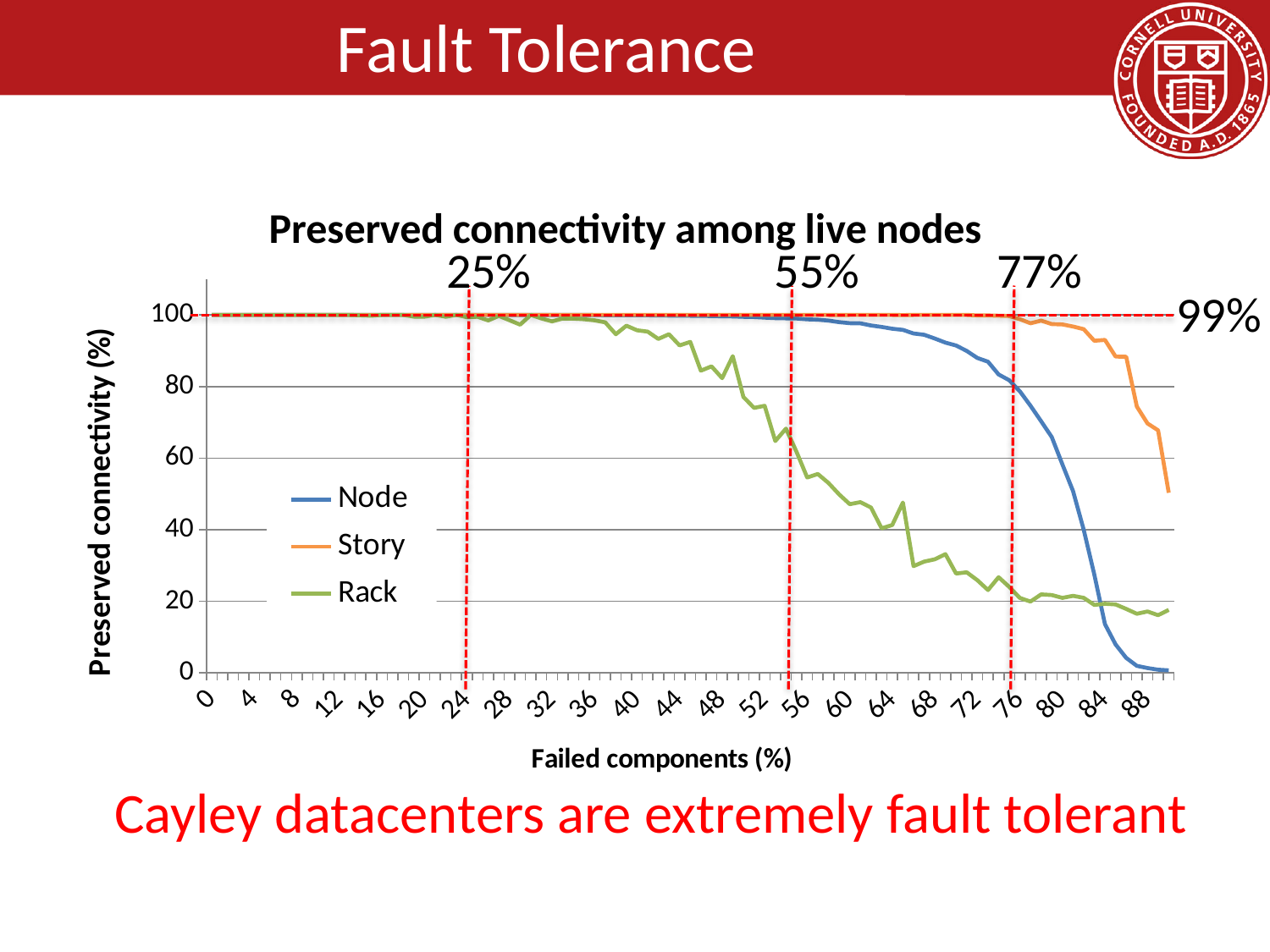
What is the title of the chart? Preserved connectivity among live nodes What is the label of the x axis? Failed components (%) Is the value of the Rack series at 88 failed components greater or less than 40? less At 40 failed components, which series has the larger value, Rack or Node? Node What kind of chart is shown on the slide? line chart Is the value of the Node series at 88 failed components greater or less than 20? less How many series does the legend list? 3 Is the value of the Node series at 80 failed components greater or less than 40? greater Does the Rack series rise or fall as failed components increase along the x axis? fall At 80 failed components, which series has the larger value, Story or Node? Story